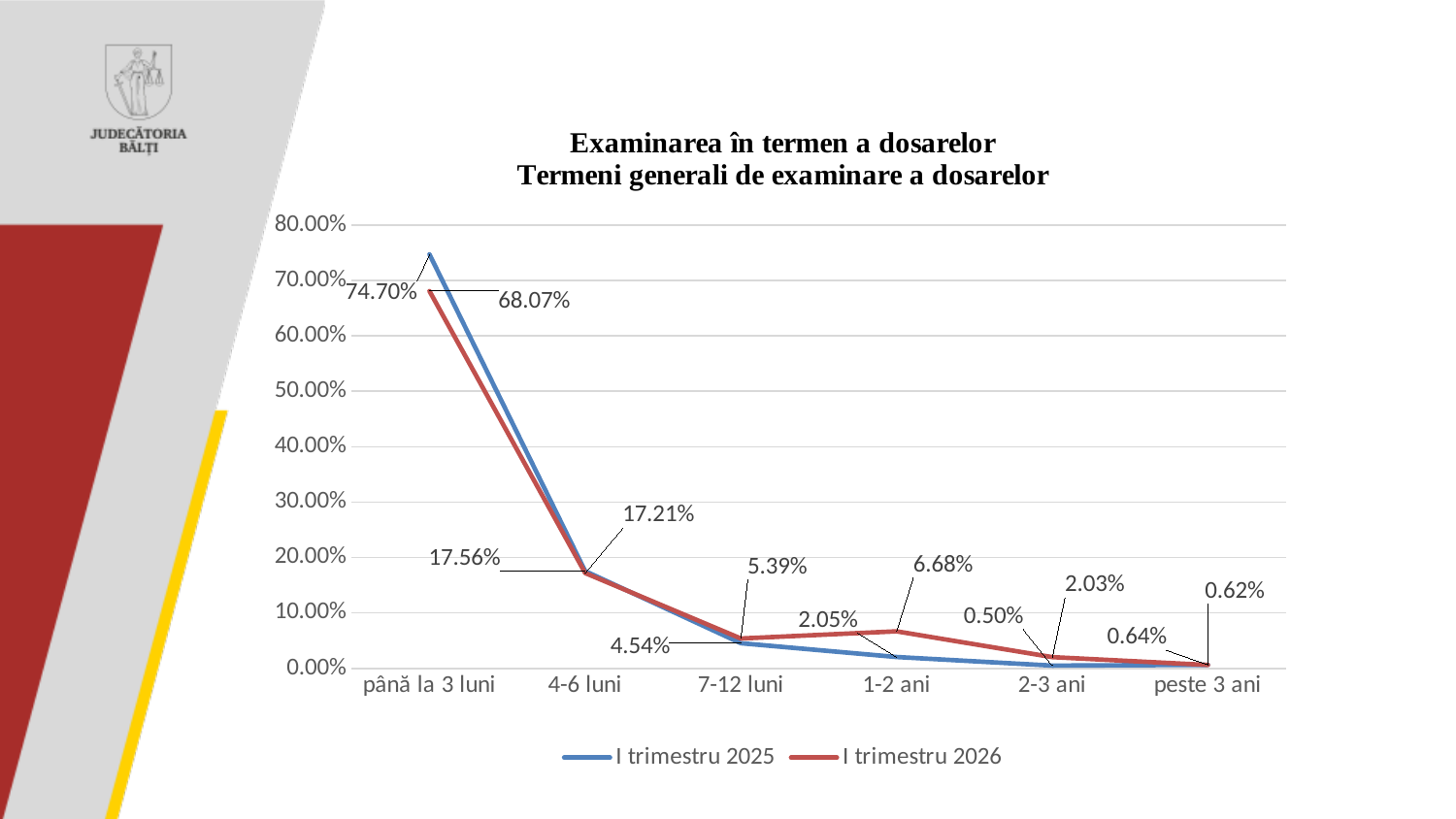
Do the values for I trimestru 2025 rise or fall from 'până la 3 luni' to '2-3 ani'? fall What are the two entries listed in the legend? I trimestru 2025 and I trimestru 2026 In the category '1-2 ani', which series has the larger value, I trimestru 2025 or I trimestru 2026? I trimestru 2026 What is the value for I trimestru 2025 in the category 'până la 3 luni'? 74.70% Is the value for I trimestru 2025 in '4-6 luni' greater or less than 20.00%? less What is the value for I trimestru 2026 in the category 'până la 3 luni'? 68.07% How many series does the legend list? 2 What is the difference between the I trimestru 2025 and I trimestru 2026 values for 'până la 3 luni'? 6.63% What is the value for I trimestru 2026 in the category '1-2 ani'? 6.68% How many categories are shown on the x axis? 6 Which category has the highest value for I trimestru 2025? până la 3 luni What kind of chart is shown on the slide? line chart